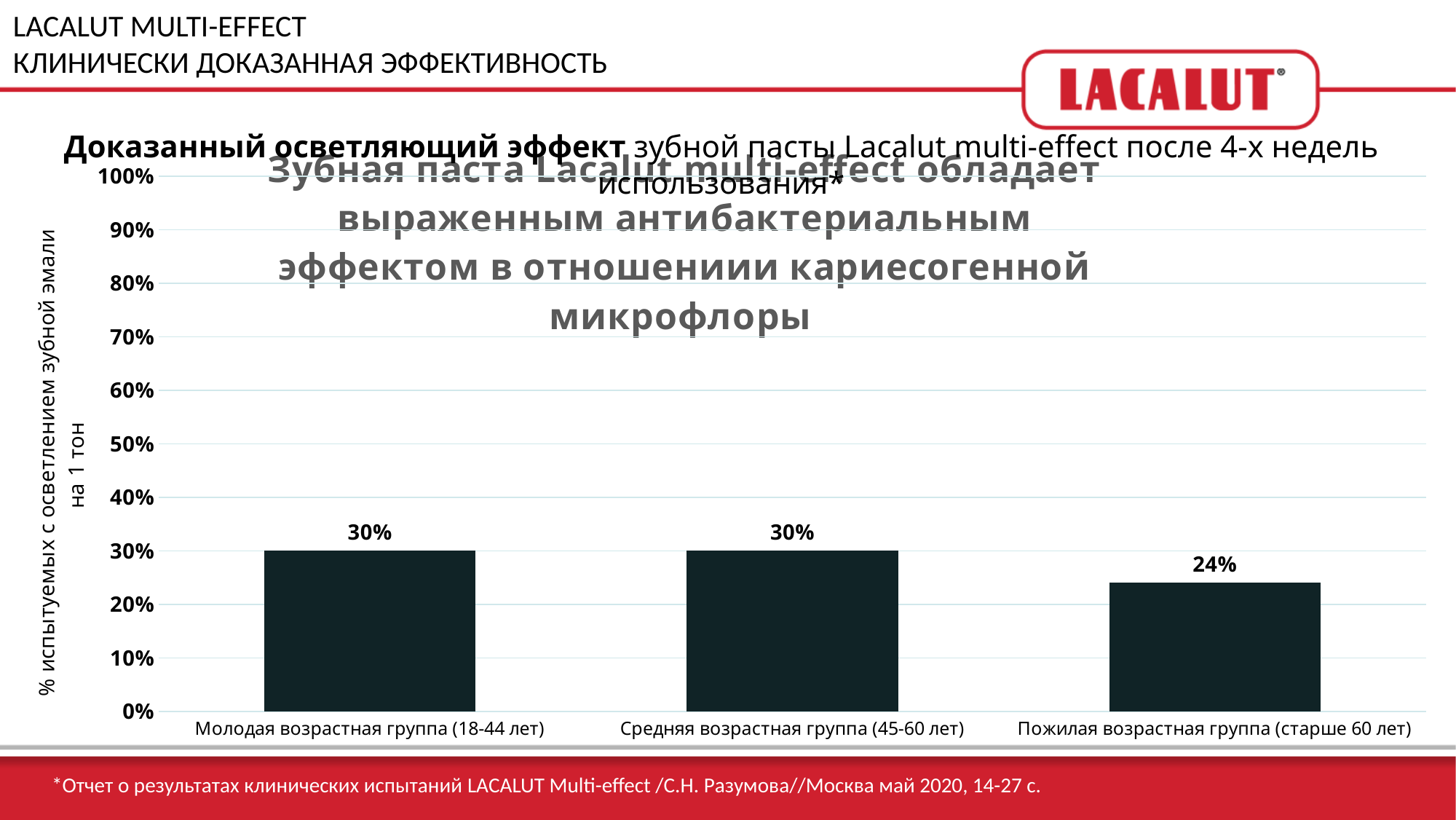
What is the value for the middle age group (45-60 years)? 30% What kind of chart is shown on the slide? bar chart What is the value for the elderly age group (over 60 years)? 24% What is the difference between the value for the middle age group (45-60 years) and the elderly age group (over 60 years)? 6% Which is larger: the value for the young age group (18-44 years) or the elderly age group (over 60 years)? Молодая возрастная группа (18-44 лет) Which age group has the lowest value? Пожилая возрастная группа (старше 60 лет) How many age groups are shown in the chart? 3 Is the value for the elderly age group (over 60 years) greater or less than 30%? less What is the maximum value shown on the vertical axis? 100% What colour are the bars in the chart? dark (black) What is the value for the young age group (18-44 years)? 30%